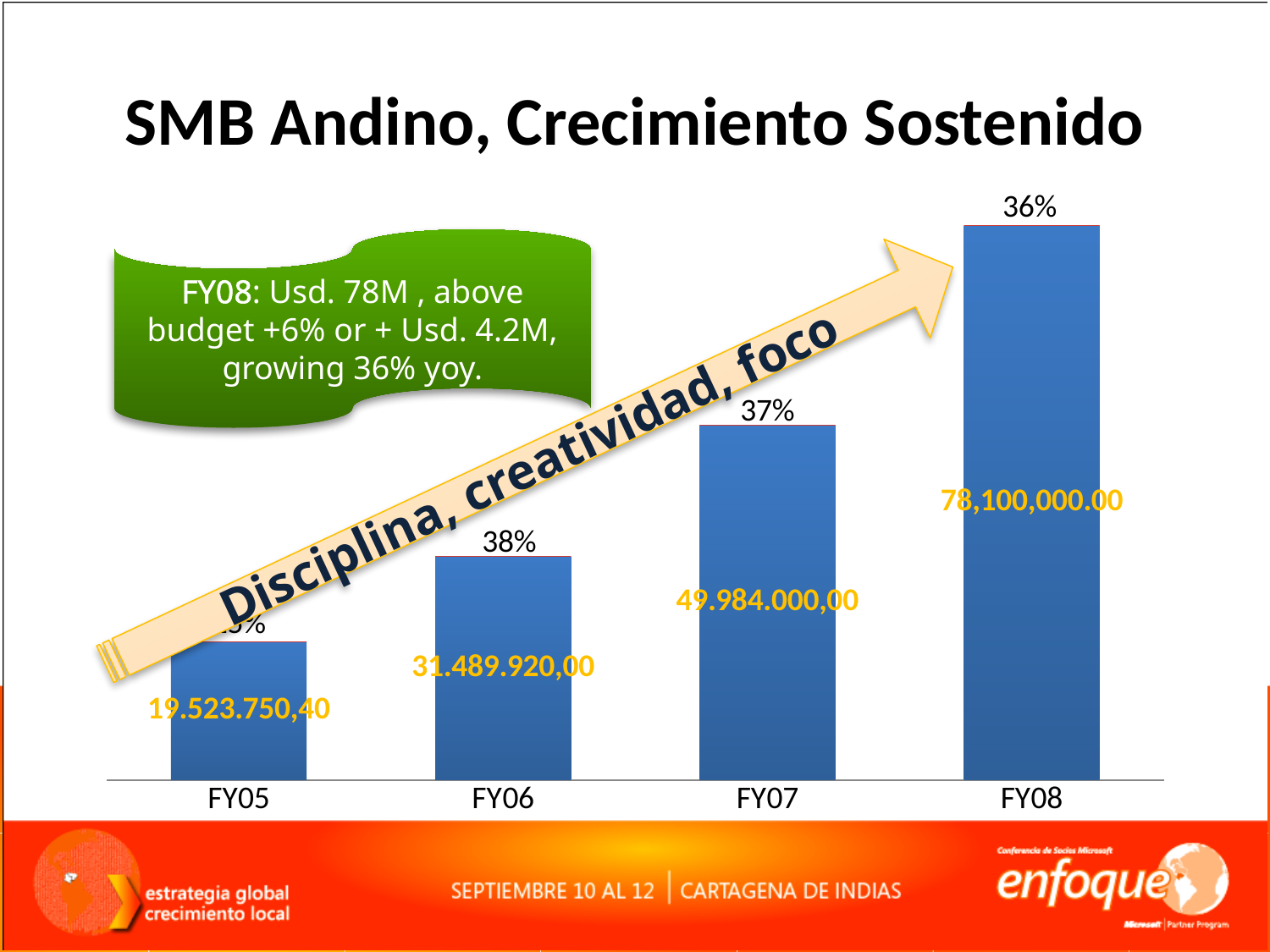
Do the values rise or fall from FY05 to FY08? Rise What kind of chart is shown on the slide? Bar chart What value is shown for FY07? 49.984.000,00 How many fiscal years are shown on the x axis? 4 What growth percentage is shown above the FY06 bar? 38% Which is larger, the value for FY06 or the value for FY07? FY07 What value is shown for FY06? 31.489.920,00 What value is shown for FY05? 19.523.750,40 What growth percentage is shown above the FY08 bar? 36% Which fiscal year has the lowest bar? FY05 What value is shown for FY08? 78,100,000.00 Which fiscal year has the highest bar? FY08